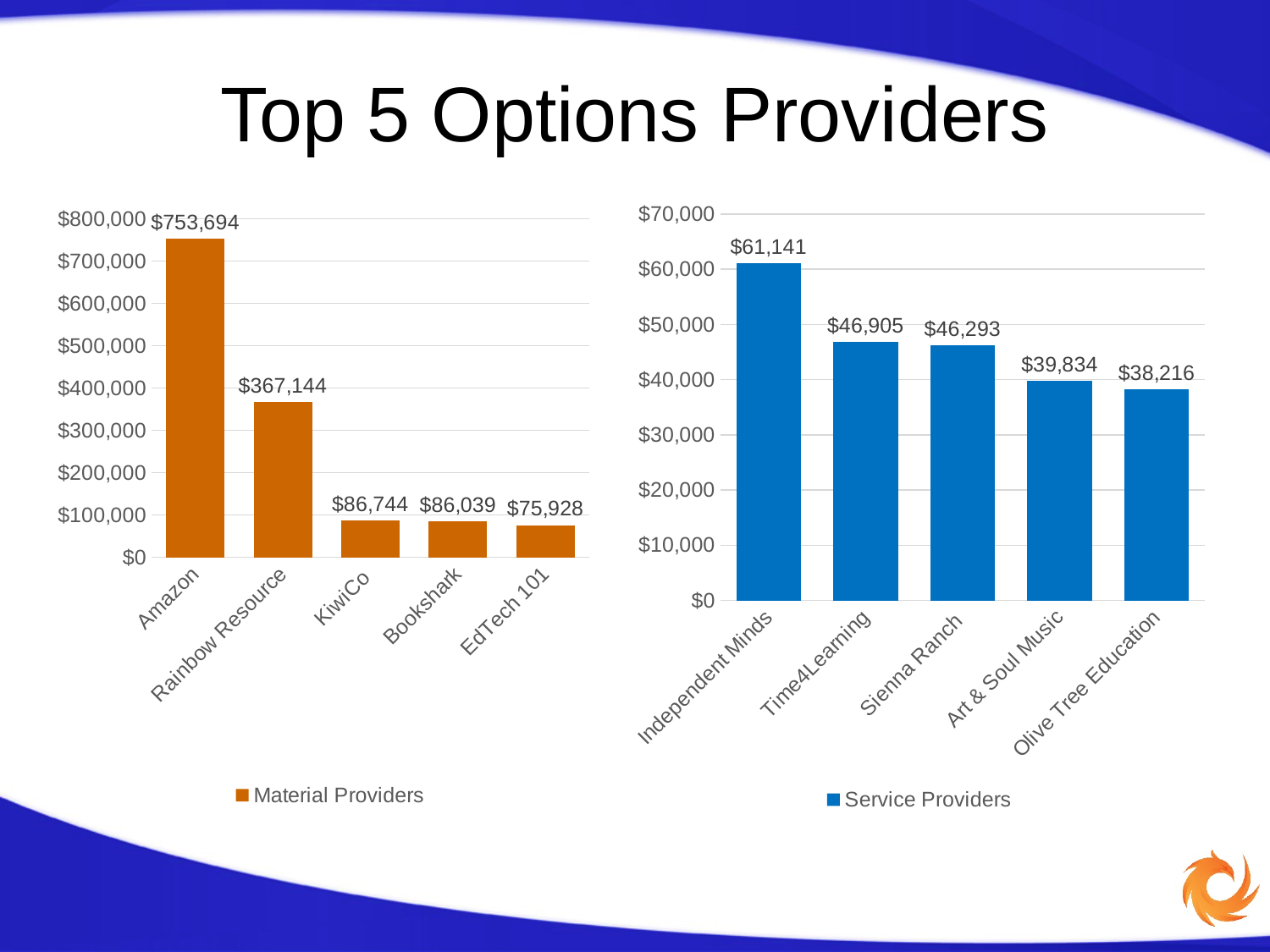
How many providers are shown in the right chart (Service Providers)? 5 In the left chart (Material Providers), is the value for EdTech 101 greater or less than $100,000? less What is the title of the slide? Top 5 Options Providers In the left chart (Material Providers), what is the difference between the values for Amazon and Rainbow Resource? $386,550 In the right chart (Service Providers), what is the difference between the values for Independent Minds and Time4Learning? $14,236 In the left chart (Material Providers), what is the value for Rainbow Resource? $367,144 In the right chart (Service Providers), which provider has the lowest value? Olive Tree Education In the right chart (Service Providers), do the values rise or fall from left to right along the x axis? fall What kind of chart is the left chart (Material Providers)? bar chart In the right chart (Service Providers), what is the value for Sienna Ranch? $46,293 In the right chart (Service Providers), which is larger: the value for Independent Minds or the value for Olive Tree Education? Independent Minds In the left chart (Material Providers), which provider has the highest value? Amazon